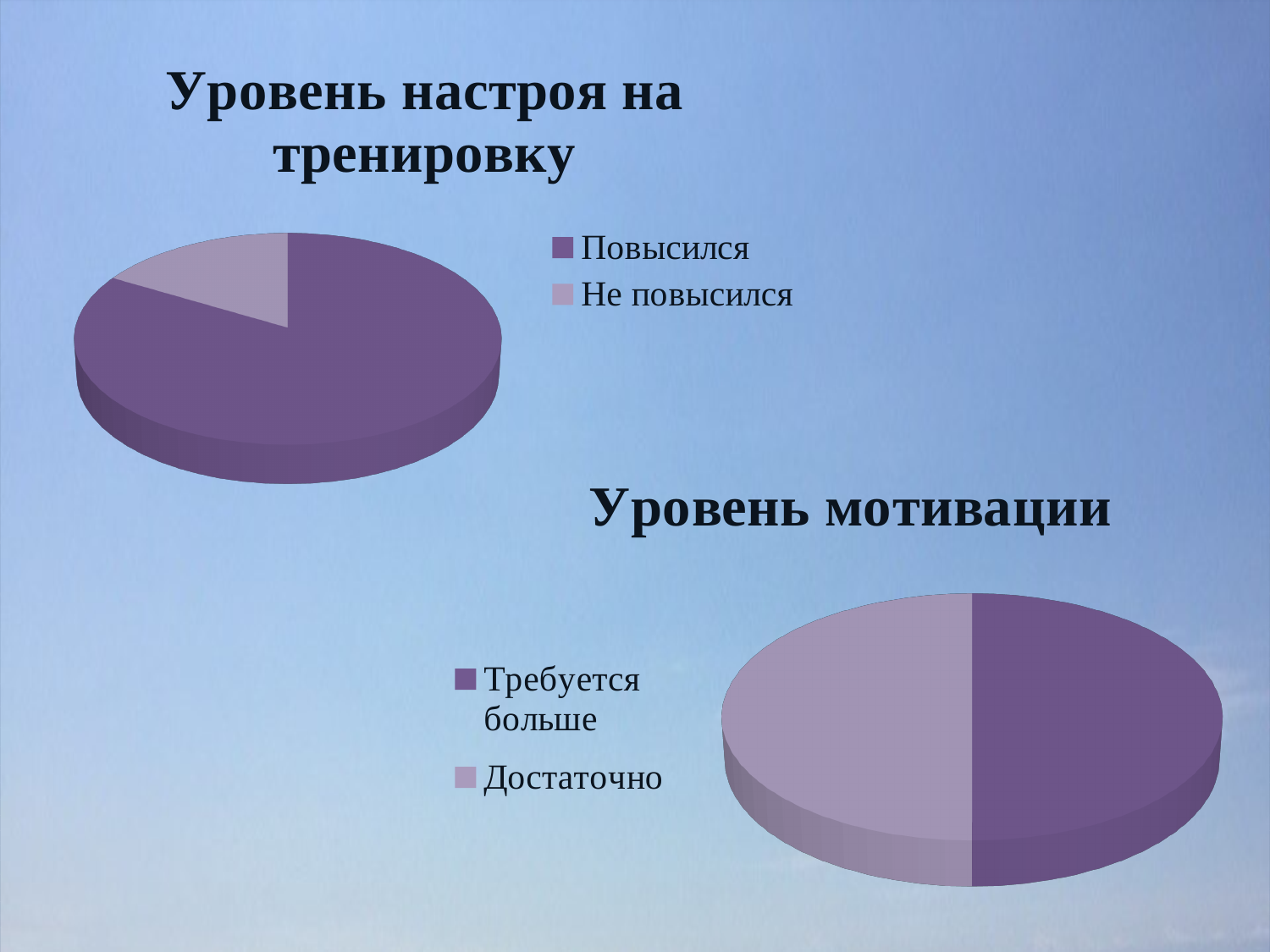
What kind of chart is the "Уровень мотивации" chart? pie chart What is the title of the chart in the upper left of the slide? Уровень настроя на тренировку In the "Уровень настроя на тренировку" chart, which slice is the largest? Повысился How many entries does the legend of the "Уровень настроя на тренировку" chart list? 2 What are the legend entries of the "Уровень мотивации" chart? Требуется больше, Достаточно How many slices does the "Уровень мотивации" chart have? 2 How many slices does the "Уровень настроя на тренировку" chart have? 2 What kind of chart is the "Уровень настроя на тренировку" chart? pie chart In the "Уровень настроя на тренировку" chart, which slice is the smallest? Не повысился How many entries does the legend of the "Уровень мотивации" chart list? 2 In the "Уровень настроя на тренировку" chart, which is larger: Повысился or Не повысился? Повысился